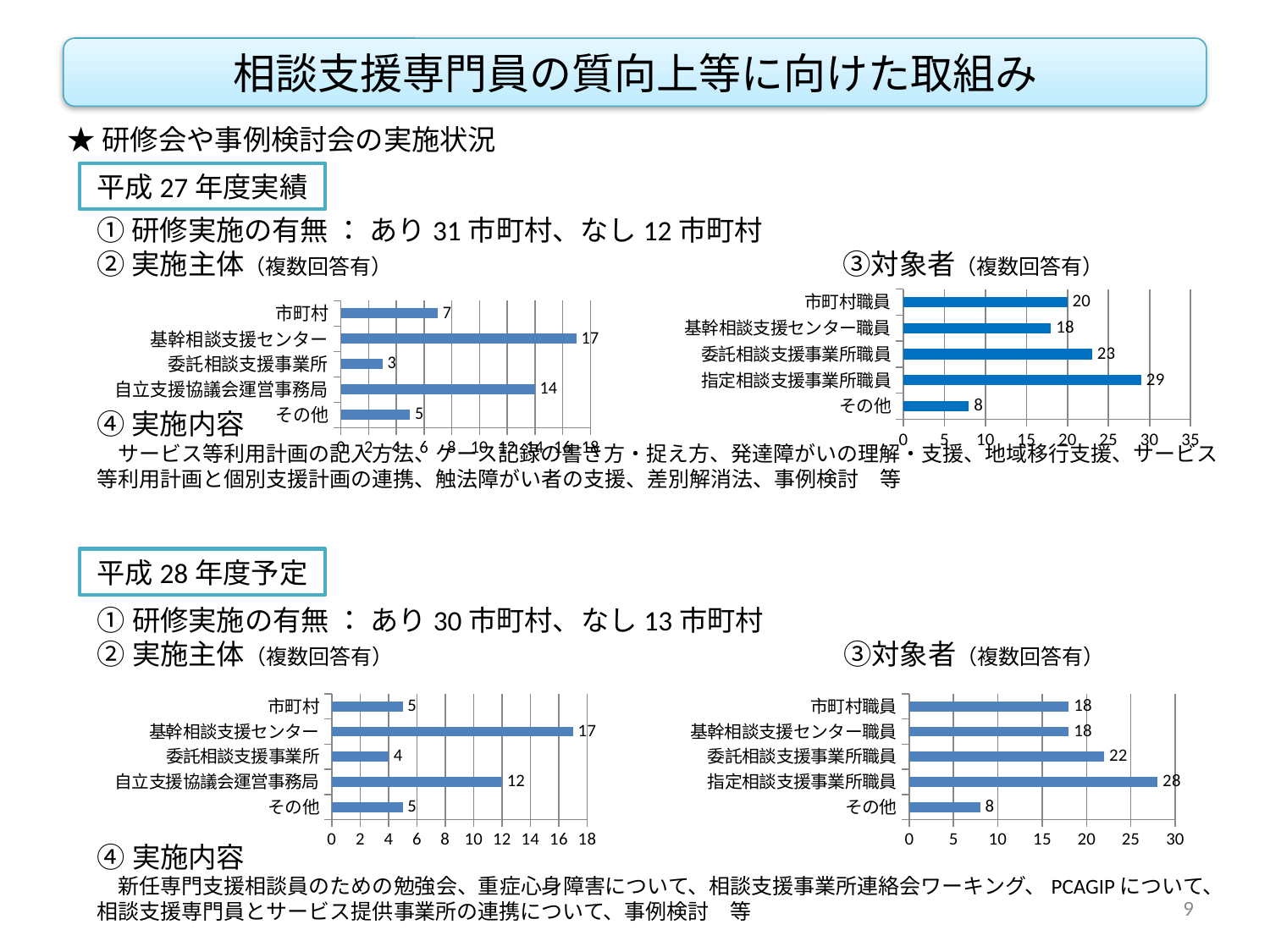
In the 平成27年度 ③対象者 chart (top-right), what is the value for その他? 8 In the 平成27年度 ② 実施主体 chart (top-left), what is the difference between 基幹相談支援センター and 自立支援協議会運営事務局? 3 In the 平成28年度 ② 実施主体 chart (bottom-left), what is the value for 自立支援協議会運営事務局? 12 What type of chart is the 平成28年度 ③対象者 chart (bottom-right)? Bar chart In the 平成27年度 ③対象者 chart (top-right), what is the difference between 指定相談支援事業所職員 and 市町村職員? 9 In the 平成27年度 ② 実施主体 chart (top-left), what is the value for 基幹相談支援センター? 17 In the 平成28年度 ② 実施主体 chart (bottom-left), how many categories are shown? 5 In the 平成28年度 ② 実施主体 chart (bottom-left), which is larger, 市町村 or 委託相談支援事業所? 市町村 In the 平成27年度 ② 実施主体 chart (top-left), which category has the lowest value? 委託相談支援事業所 In the 平成28年度 ③対象者 chart (bottom-right), what is the value for 委託相談支援事業所職員? 22 In the 平成28年度 ③対象者 chart (bottom-right), what is the difference between 指定相談支援事業所職員 and その他? 20 In the 平成27年度 ③対象者 chart (top-right), which category has the highest value? 指定相談支援事業所職員